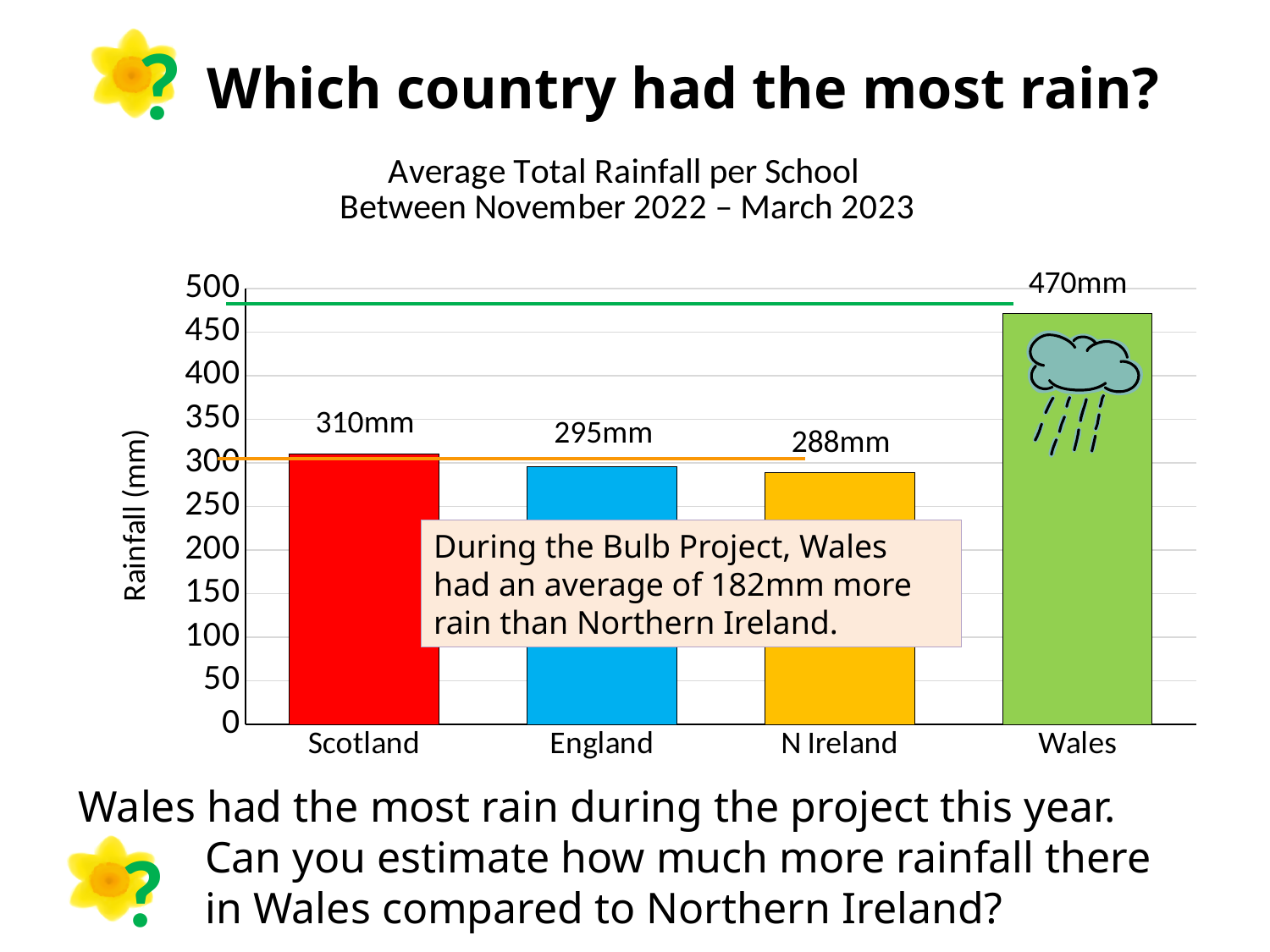
How much more rainfall did Wales have than N Ireland? 182mm Which had more rainfall, Scotland or Wales? Wales What is the average total rainfall shown for England? 295mm What is the average total rainfall shown for Scotland? 310mm Which country has the highest average total rainfall? Wales How much more rainfall did Scotland have than England? 15mm What is the average total rainfall shown for N Ireland? 288mm How many countries are shown on the chart? 4 What is the label on the vertical axis of the chart? Rainfall (mm) What is the average total rainfall shown for Wales? 470mm Which country has the lowest average total rainfall? N Ireland What type of chart is shown on the slide? Bar chart